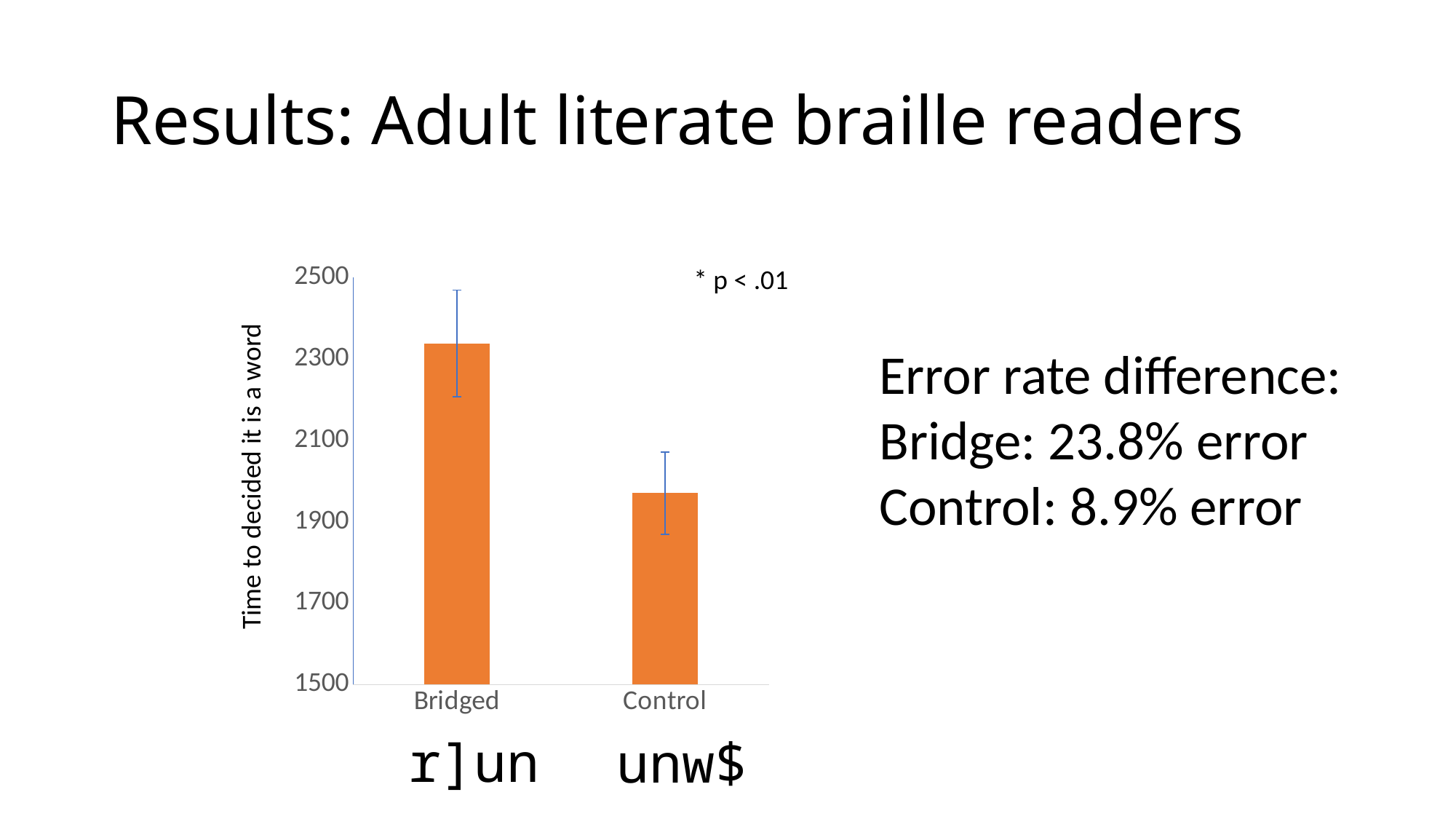
Do the values fall or rise from Bridged to Control along the x axis? fall What is the lowest value shown on the y axis of the chart? 1500 Is the value for Control greater or less than 1900? greater What kind of chart is shown on the slide? bar chart Which category has the highest bar in the chart? Bridged How many categories are plotted on the x axis of the chart? 2 Is the value for Bridged greater or less than 2300? greater Which category has the lowest bar in the chart? Control Is the value for Bridged greater or less than 2500? less What is the label of the y axis of the chart? Time to decided it is a word Is the bar for Bridged taller or shorter than the bar for Control? taller